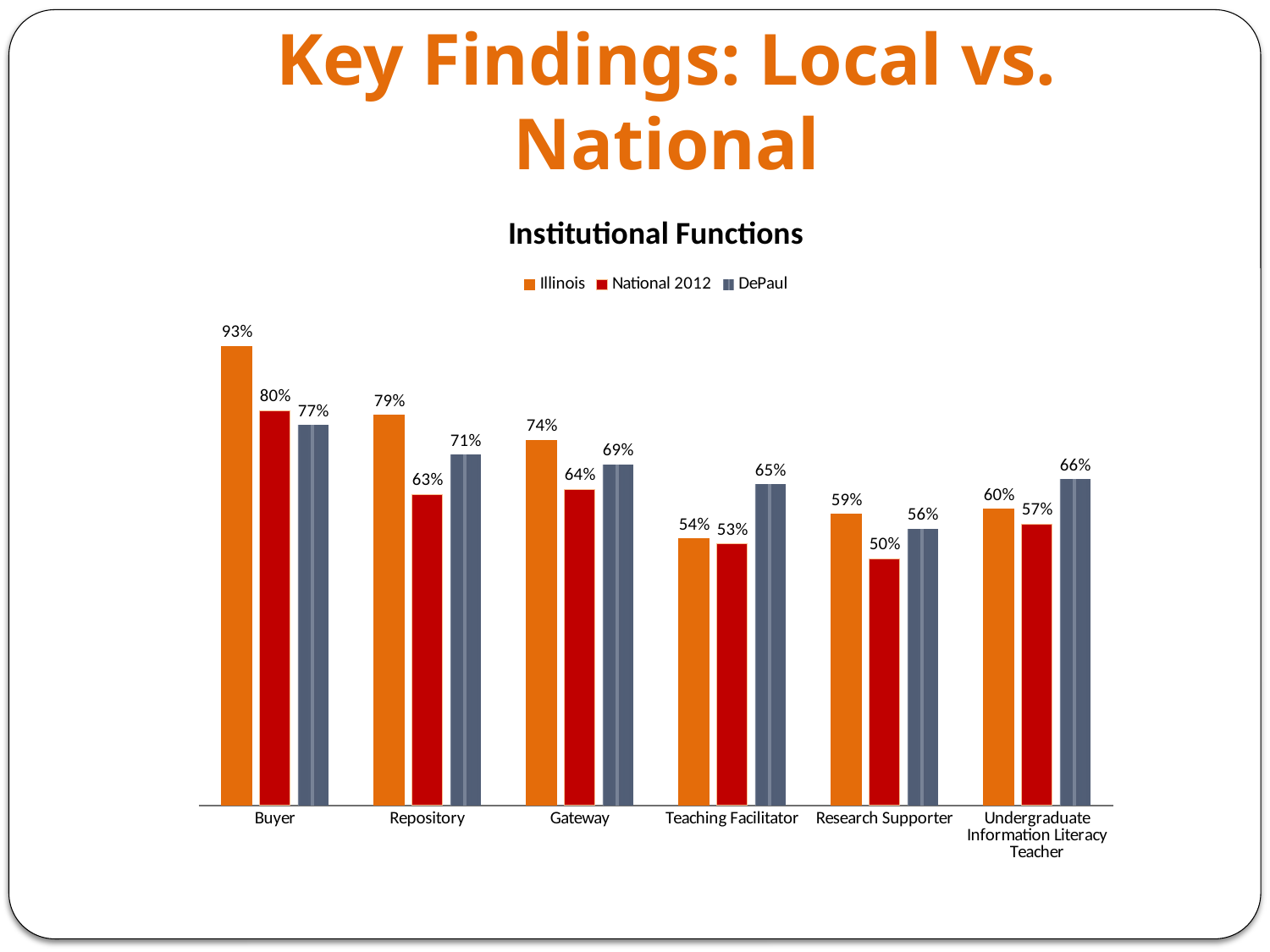
What is the Illinois value for Buyer? 93% Which category has the lowest National 2012 value? Research Supporter What kind of chart is shown? Bar chart What is the National 2012 value for Research Supporter? 50% What is the DePaul value for Repository? 71% Which series is shown in red? National 2012 Which is larger for Teaching Facilitator: the Illinois value or the DePaul value? DePaul How many categories are shown on the x axis? 6 Which category has the highest Illinois value? Buyer How many series does the legend list? 3 What is the title of the chart? Institutional Functions What is the difference between the Illinois and National 2012 values for Repository? 16%